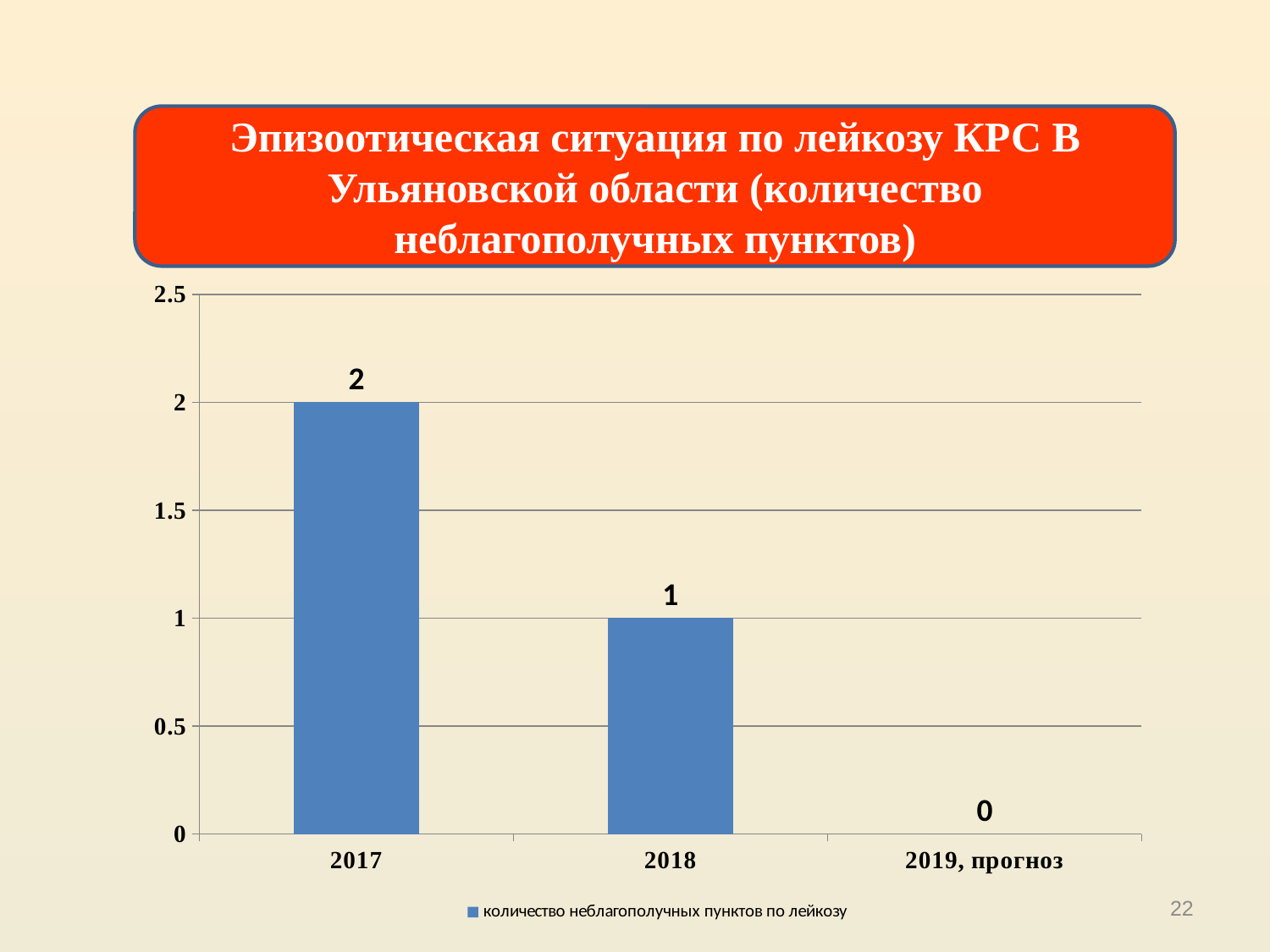
Is the value for 2017 greater or less than 1.5? greater What kind of chart is shown on the slide? bar chart Which is larger, the value for 2017 or the value for 2018? 2017 Which category has the lowest value? 2019, прогноз What is the value for 2019, прогноз? 0 How many series does the legend list? 1 How many categories are shown on the x axis? 3 What is the value for 2018? 1 What is the value for 2017? 2 Do the values rise or fall from 2017 to 2019, прогноз? fall Which category has the highest value? 2017 What is the difference between the values for 2017 and 2018? 1